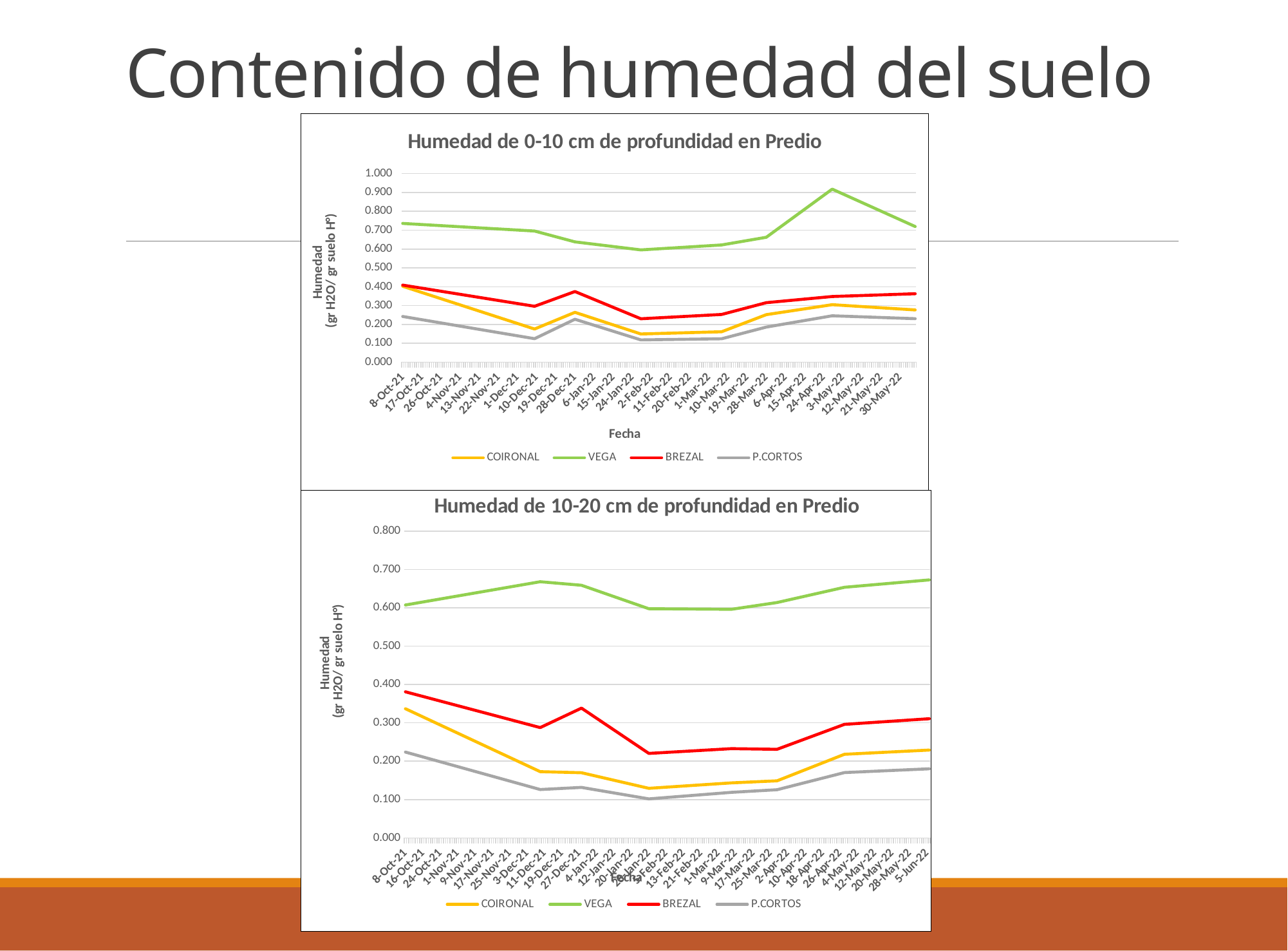
In the bottom chart, 'Humedad de 10-20 cm de profundidad en Predio', does the COIRONAL series rise or fall from 8-Oct-21 to 11-Dec-21? fall In the top chart, 'Humedad de 0-10 cm de profundidad en Predio', is the BREZAL value at 2-Feb-22 greater or less than 0.300? less In the top chart, 'Humedad de 0-10 cm de profundidad en Predio', is the VEGA value at 3-May-22 greater or less than 0.800? greater In the bottom chart, 'Humedad de 10-20 cm de profundidad en Predio', which is larger at 8-Oct-21: BREZAL or COIRONAL? BREZAL In the bottom chart, 'Humedad de 10-20 cm de profundidad en Predio', is the P.CORTOS value at 20-Jan-22 greater or less than 0.200? less What kind of chart is the top chart, 'Humedad de 0-10 cm de profundidad en Predio'? line chart In the bottom chart, 'Humedad de 10-20 cm de profundidad en Predio', which series has the lowest values across the whole period? P.CORTOS How many series does the legend of the bottom chart, 'Humedad de 10-20 cm de profundidad en Predio', list? 4 In the top chart, 'Humedad de 0-10 cm de profundidad en Predio', does the VEGA series rise or fall from 3-May-22 to 30-May-22? fall In the top chart, 'Humedad de 0-10 cm de profundidad en Predio', which series has the highest values across the whole period? VEGA What colour is the VEGA line in the top chart, 'Humedad de 0-10 cm de profundidad en Predio'? green